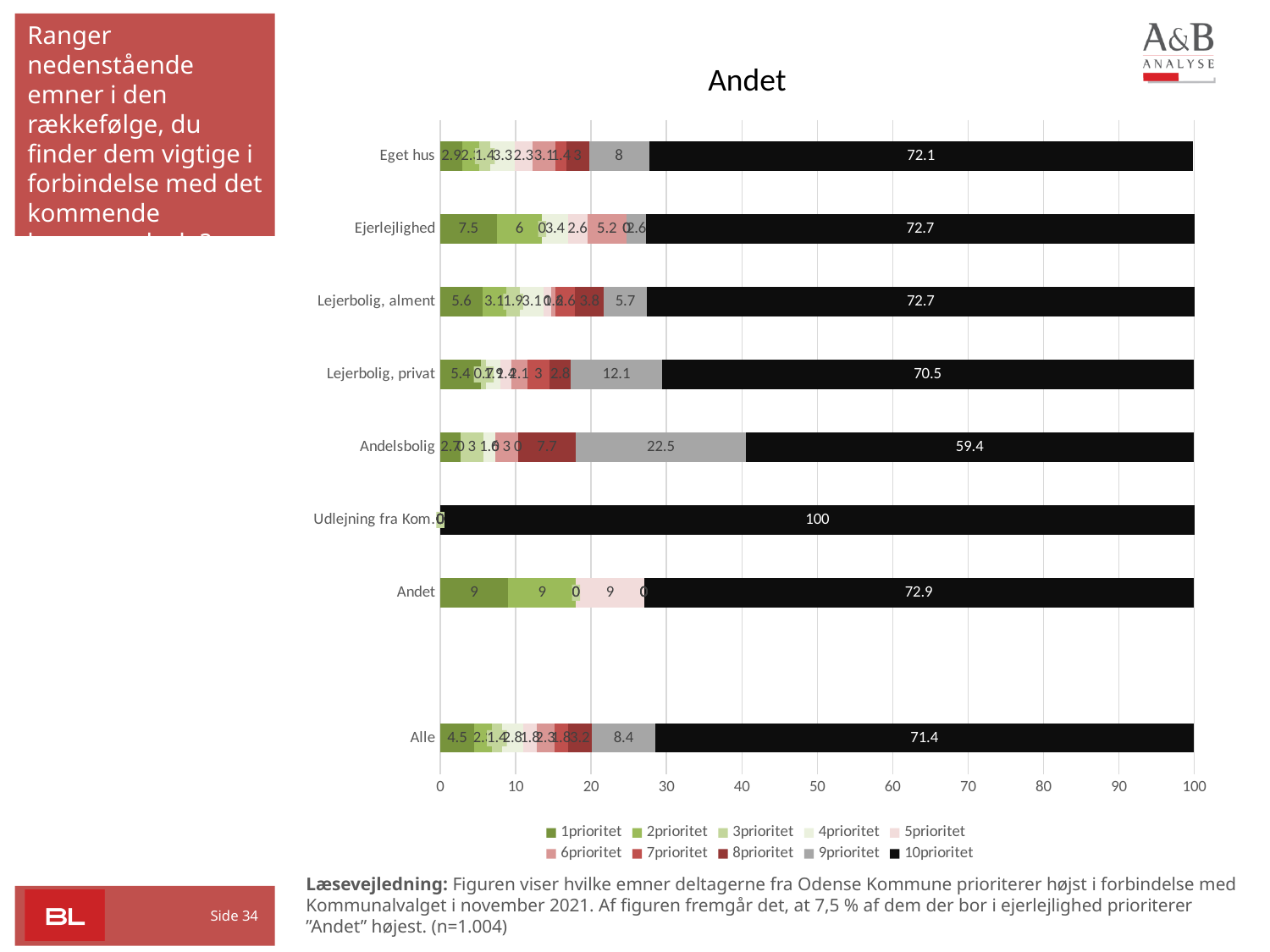
What is the value of the 9prioritet segment for Lejerbolig, privat? 12.1 Which category has the lowest 10prioritet value? Andelsbolig What is the value of the 10prioritet segment for Andelsbolig? 59.4 Which is larger, the 9prioritet value for Andelsbolig or for Alle? Andelsbolig What kind of chart is shown? Stacked bar chart What is the value of the 10prioritet segment for Eget hus? 72.1 How many series does the legend list? 10 How many categories are shown on the y axis? 8 What is the title of the chart? Andet What is the value of the 1prioritet segment for Ejerlejlighed? 7.5 Which category has the highest 10prioritet value? Udlejning fra Kom. What is the difference between the 10prioritet values for Ejerlejlighed and Eget hus? 0.6